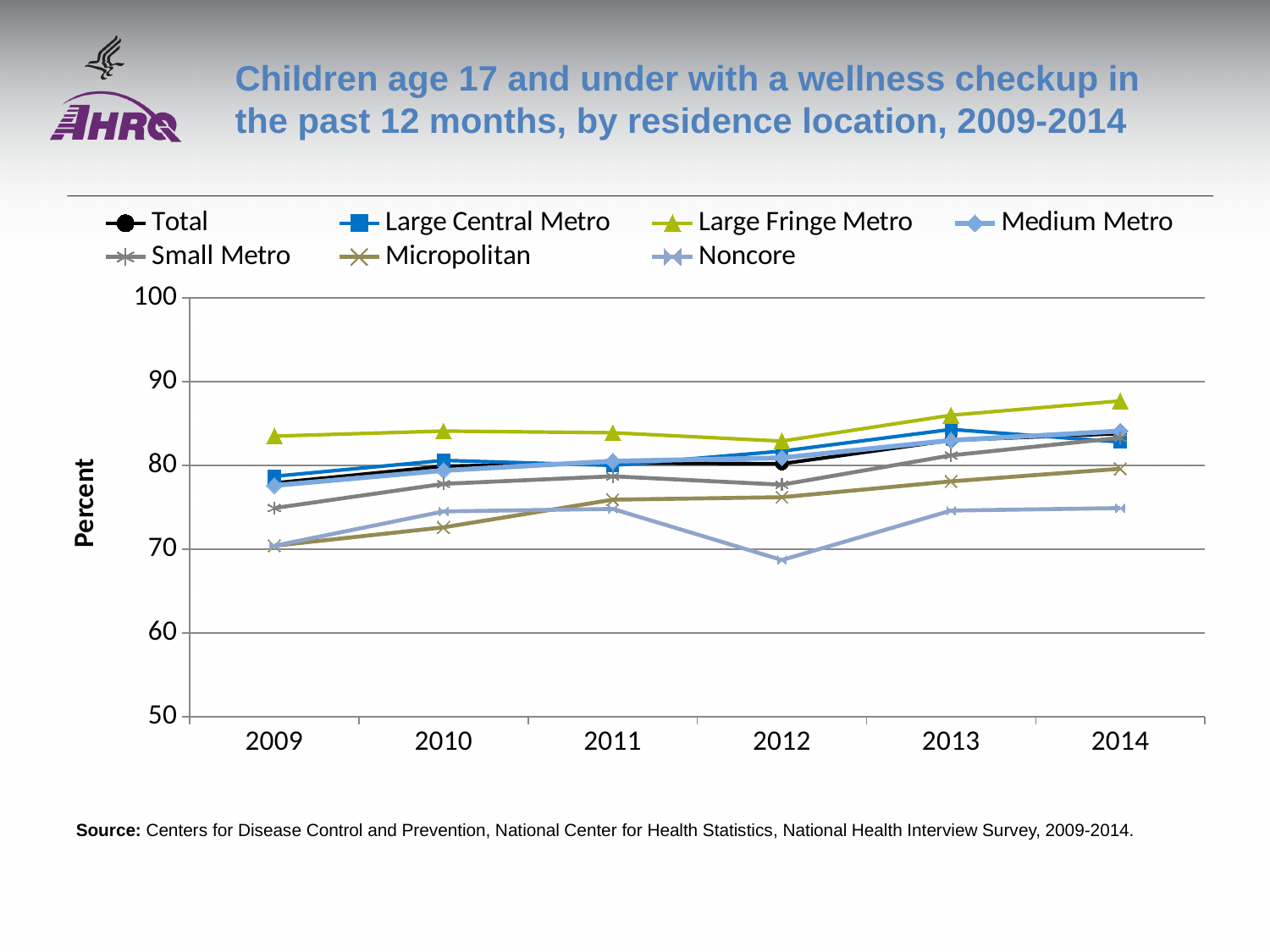
Which residence location has the lowest value in 2012? Noncore Is the value for Noncore in 2012 greater or less than 70? less What is the label on the y axis? Percent Is the value for Large Fringe Metro in 2014 greater or less than 85? greater Is the value for Micropolitan in 2009 greater or less than 75? less What kind of chart is shown on the slide? line chart Does the Micropolitan line rise or fall from 2009 to 2014? rise Does the Noncore line rise or fall from 2011 to 2012? fall In 2013, which is larger: the value for Large Fringe Metro or the value for Noncore? Large Fringe Metro Which residence location has the highest value in 2014? Large Fringe Metro How many series does the legend list? 7 How many years are shown along the x axis? 6